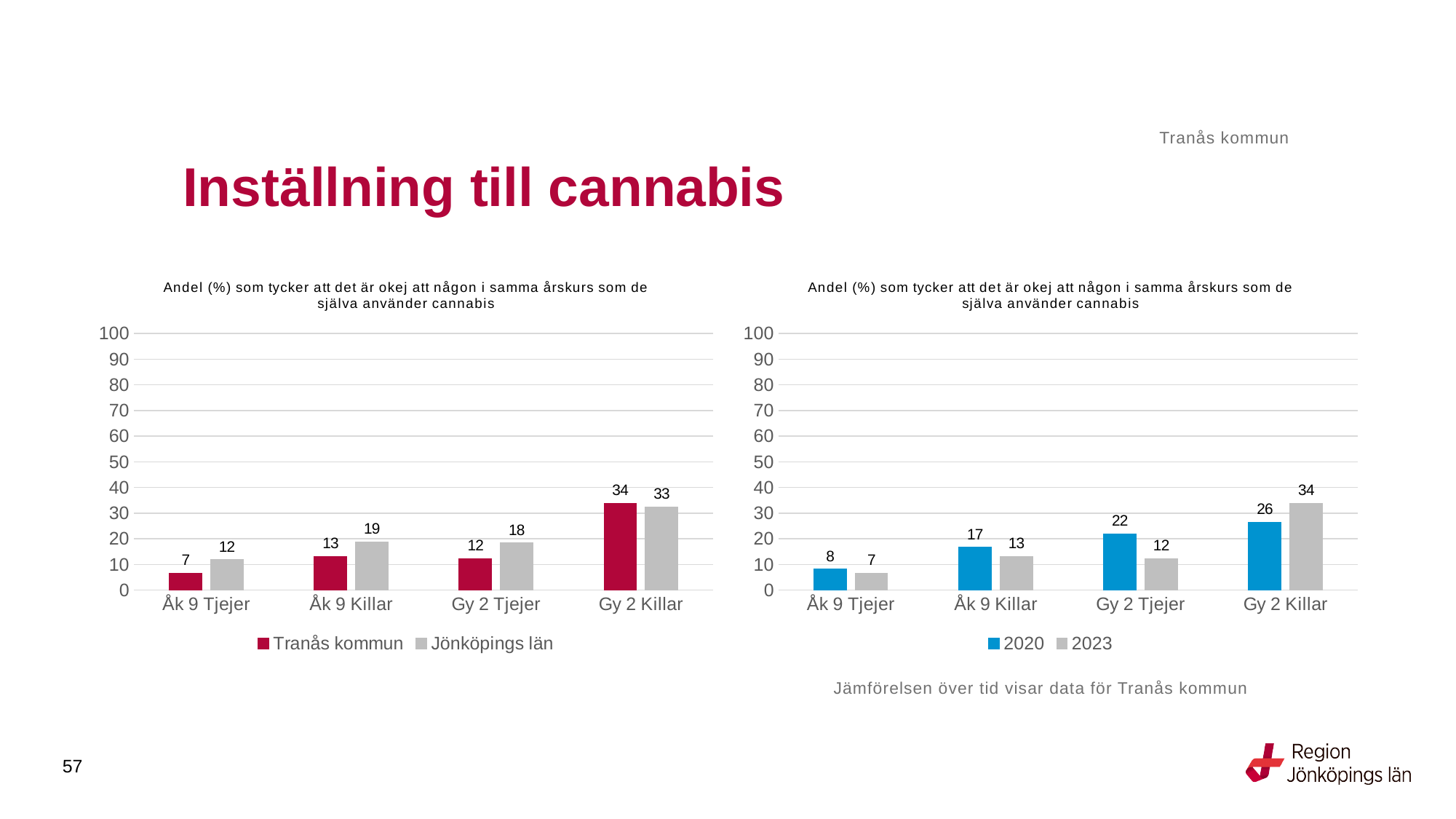
In the right chart, which category has the lowest value for 2023? Åk 9 Tjejer In the left chart, what is the value for Tranås kommun for Gy 2 Killar? 34 In the right chart, which is larger for Gy 2 Killar: 2020 or 2023? 2023 How many categories are shown on the x axis of the left chart? 4 In the right chart, what is the value for 2023 for Åk 9 Tjejer? 7 In the left chart, what is the difference between Jönköpings län and Tranås kommun for Åk 9 Killar? 6 In the left chart, what is the value for Jönköpings län for Åk 9 Killar? 19 In the left chart, which category has the highest value for Tranås kommun? Gy 2 Killar In the right chart, what is the difference between 2020 and 2023 for Gy 2 Tjejer? 10 What type of chart is the left chart? Bar chart How many series does the legend of the right chart list? 2 In the right chart, what is the value for 2020 for Gy 2 Tjejer? 22